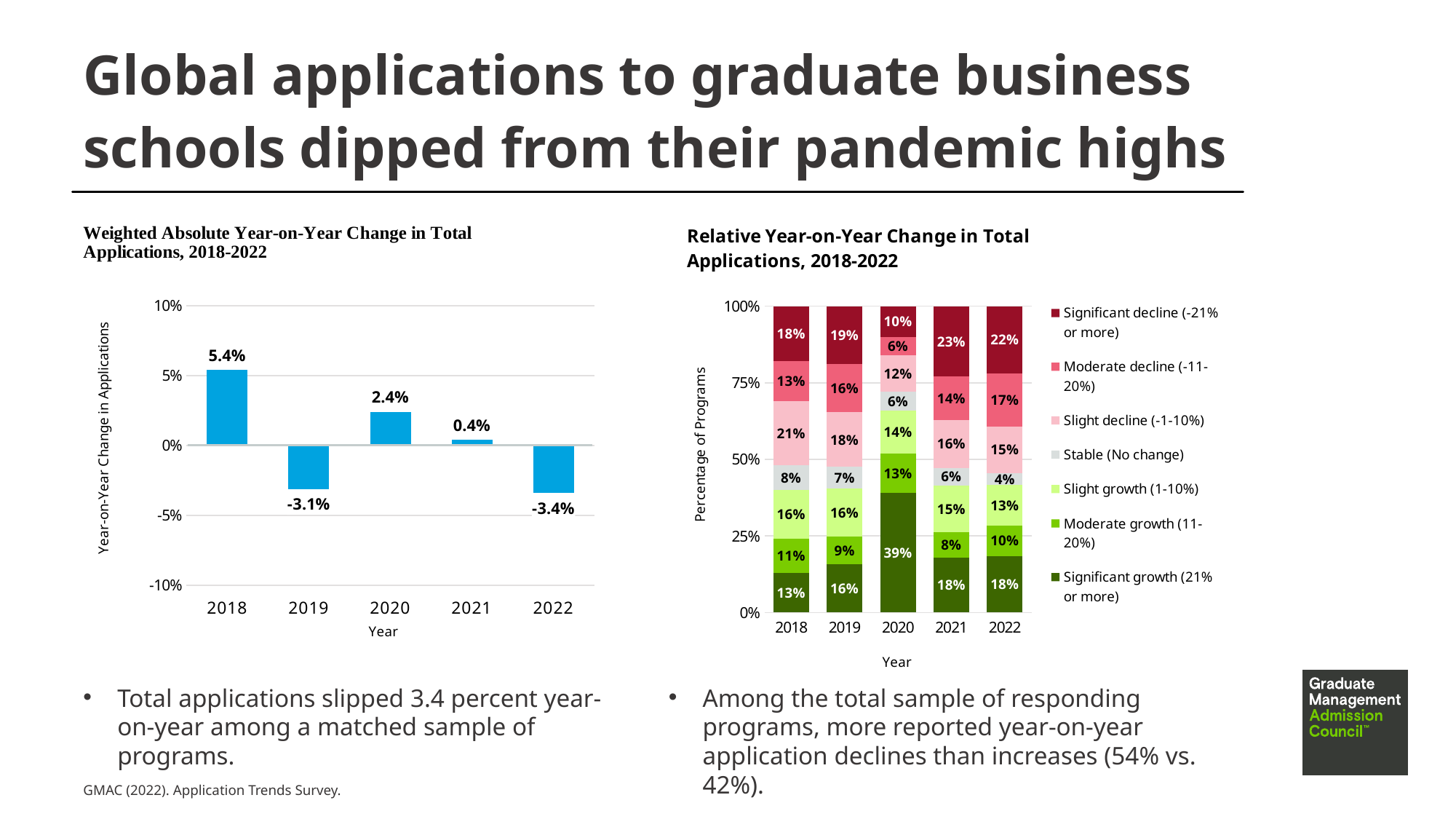
In the 'Relative Year-on-Year Change in Total Applications, 2018-2022' chart, which year has the largest significant growth (21% or more) segment? 2020 In the 'Relative Year-on-Year Change in Total Applications, 2018-2022' chart, how many series does the legend list? 7 In the 'Relative Year-on-Year Change in Total Applications, 2018-2022' chart, what percentage of programs reported significant growth (21% or more) in 2020? 39% In the 'Weighted Absolute Year-on-Year Change in Total Applications, 2018-2022' chart, how many years are shown on the x axis? 5 In the 'Relative Year-on-Year Change in Total Applications, 2018-2022' chart, what percentage of programs reported a significant decline (-21% or more) in 2021? 23% In the 'Relative Year-on-Year Change in Total Applications, 2018-2022' chart, which is larger: the moderate decline (-11-20%) share in 2022 or in 2018? 2022 In the 'Weighted Absolute Year-on-Year Change in Total Applications, 2018-2022' chart, what is the value for 2022? -3.4% What type of chart is the 'Weighted Absolute Year-on-Year Change in Total Applications, 2018-2022' chart? Bar chart In the 'Weighted Absolute Year-on-Year Change in Total Applications, 2018-2022' chart, what is the value for 2018? 5.4% In the 'Weighted Absolute Year-on-Year Change in Total Applications, 2018-2022' chart, which year has the highest value? 2018 In the 'Weighted Absolute Year-on-Year Change in Total Applications, 2018-2022' chart, which year has the lowest value? 2022 In the 'Weighted Absolute Year-on-Year Change in Total Applications, 2018-2022' chart, what is the difference between the 2018 value and the 2020 value? 3.0 percentage points